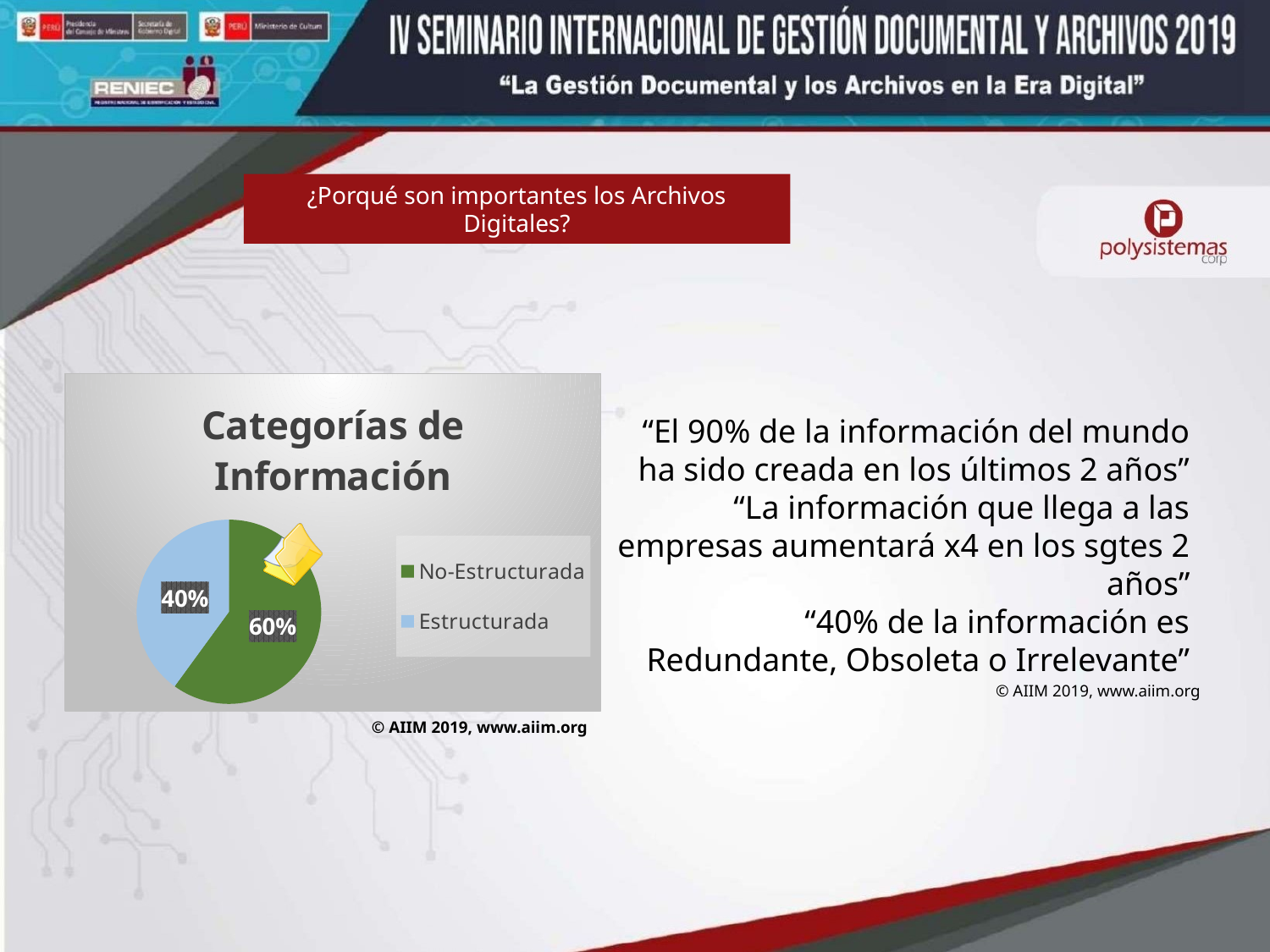
Which is larger in the pie chart, No-Estructurada or Estructurada? No-Estructurada Which category has the largest share in the pie chart? No-Estructurada What is the title of the pie chart? Categorías de Información Which colour represents Estructurada in the pie chart? light blue How many categories does the pie chart show? 2 What is the value for No-Estructurada in the pie chart? 60% Is the share for No-Estructurada in the pie chart greater or less than 50%? greater What is the value for Estructurada in the pie chart? 40% What is the difference between the No-Estructurada and Estructurada shares in the pie chart? 20% What kind of chart is shown under the title "Categorías de Información"? pie chart How many entries does the legend of the pie chart list? 2 Which category has the smallest share in the pie chart? Estructurada